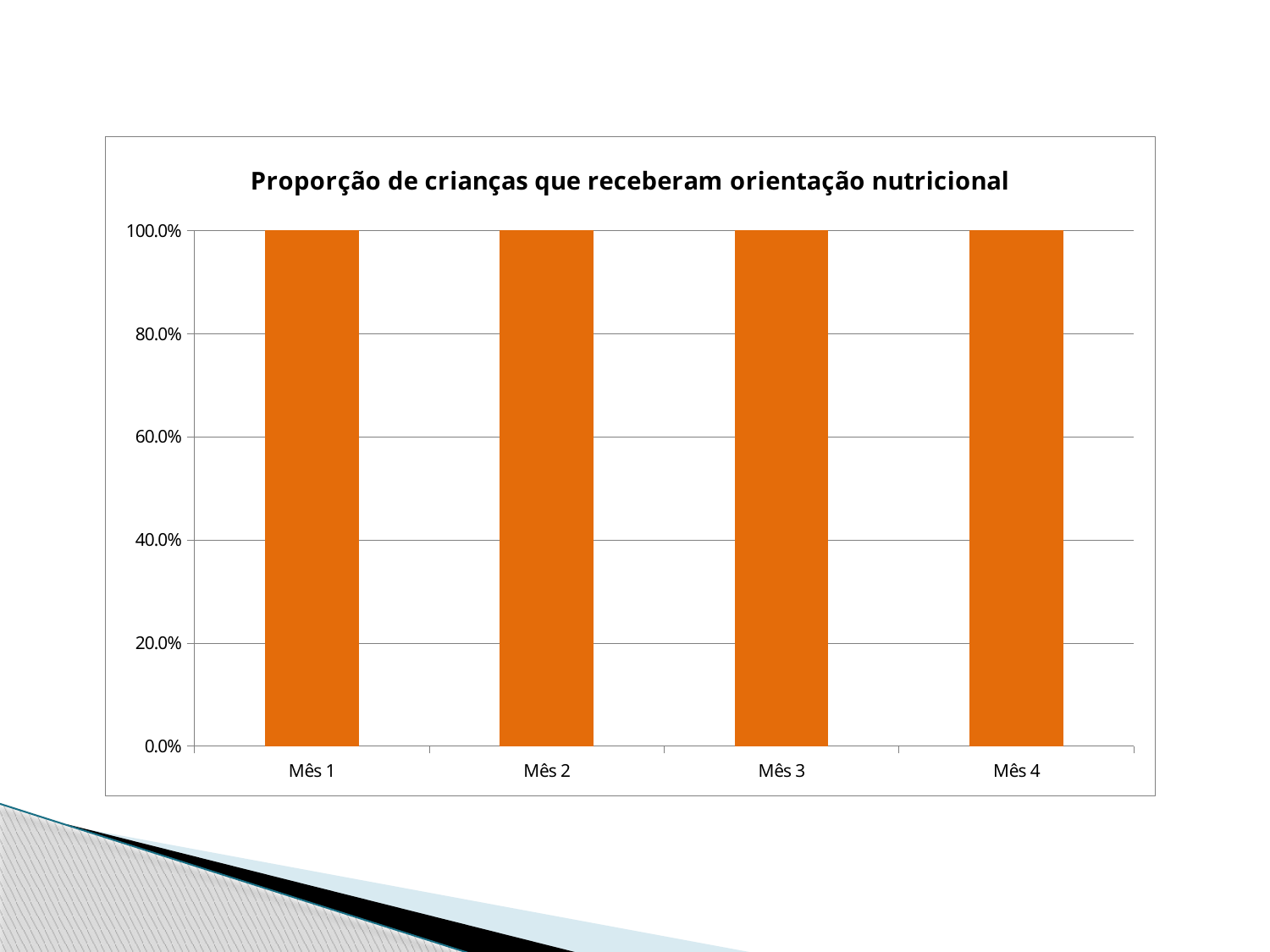
What is the value for Mês 1? 100.0% Is the value for Mês 1 greater or less than 60.0%? greater What is the value for Mês 4? 100.0% What is the value for Mês 3? 100.0% What kind of chart is shown on the slide? bar chart What is the title of the chart? Proporção de crianças que receberam orientação nutricional Do the values rise, fall or stay the same from Mês 1 to Mês 4? stay the same What is the difference between the values for Mês 1 and Mês 4? 0.0% How many categories are shown on the x axis of the chart? 4 Is the value for Mês 3 greater or less than 80.0%? greater What colour are the bars in the chart? orange What is the value for Mês 2? 100.0%